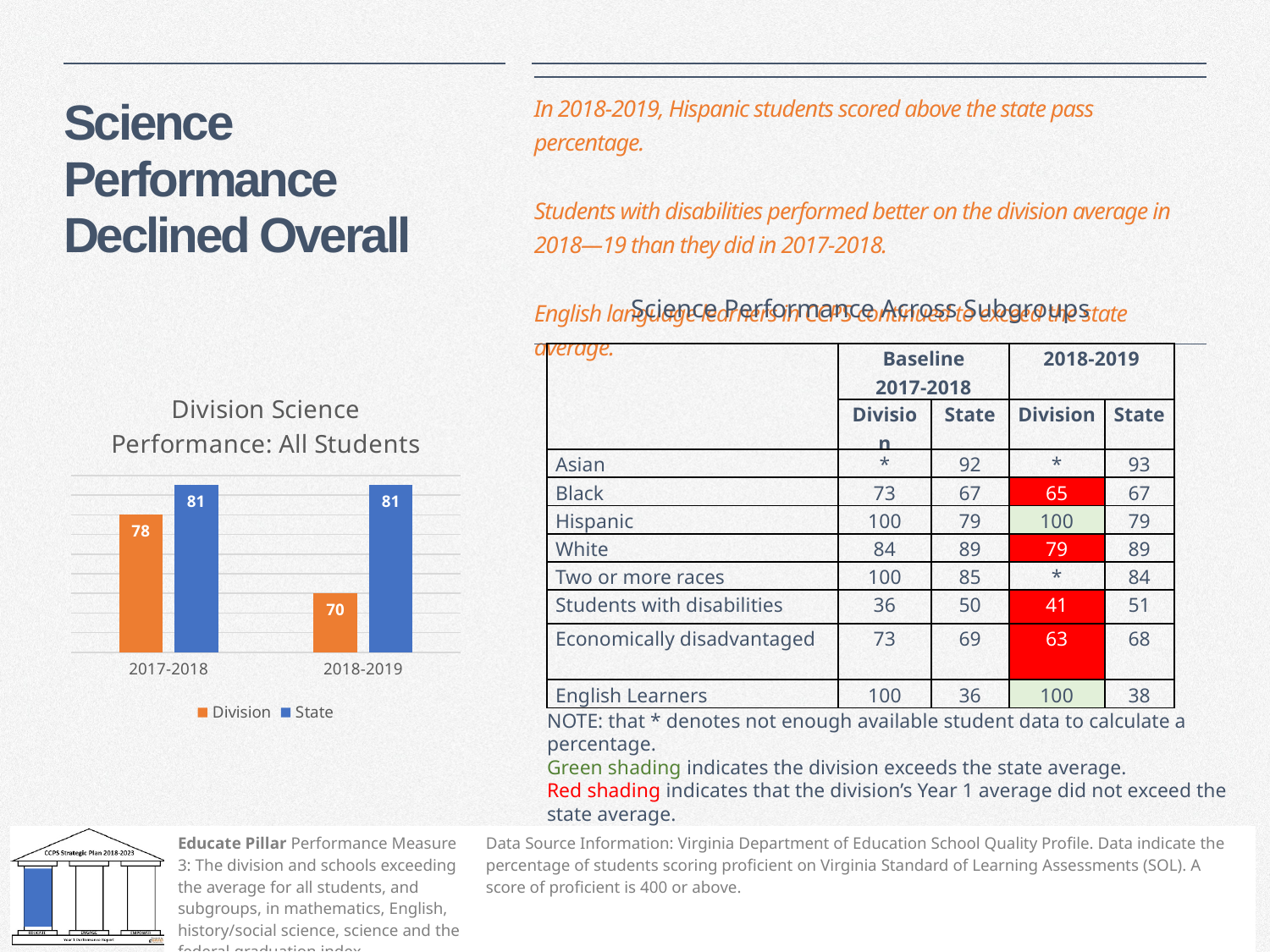
In the Division Science Performance: All Students chart, which year has the lowest Division value? 2018-2019 In the Division Science Performance: All Students chart, how much did the Division value fall from 2017-2018 to 2018-2019? 8 In the Division Science Performance: All Students chart, which is larger for 2017-2018, the Division value or the State value? State What is the Division value for 2017-2018 in the Division Science Performance: All Students chart? 78 What kind of chart is the Division Science Performance: All Students chart? Bar chart In the Division Science Performance: All Students chart, which colour represents the State series? Blue In the Division Science Performance: All Students chart, does the Division value rise or fall from 2017-2018 to 2018-2019? Fall How many year categories are shown on the x axis of the Division Science Performance: All Students chart? 2 What is the State value for 2018-2019 in the Division Science Performance: All Students chart? 81 How many series does the legend of the Division Science Performance: All Students chart list? 2 What is the Division value for 2018-2019 in the Division Science Performance: All Students chart? 70 In the Division Science Performance: All Students chart, what is the difference between the State and Division values for 2018-2019? 11